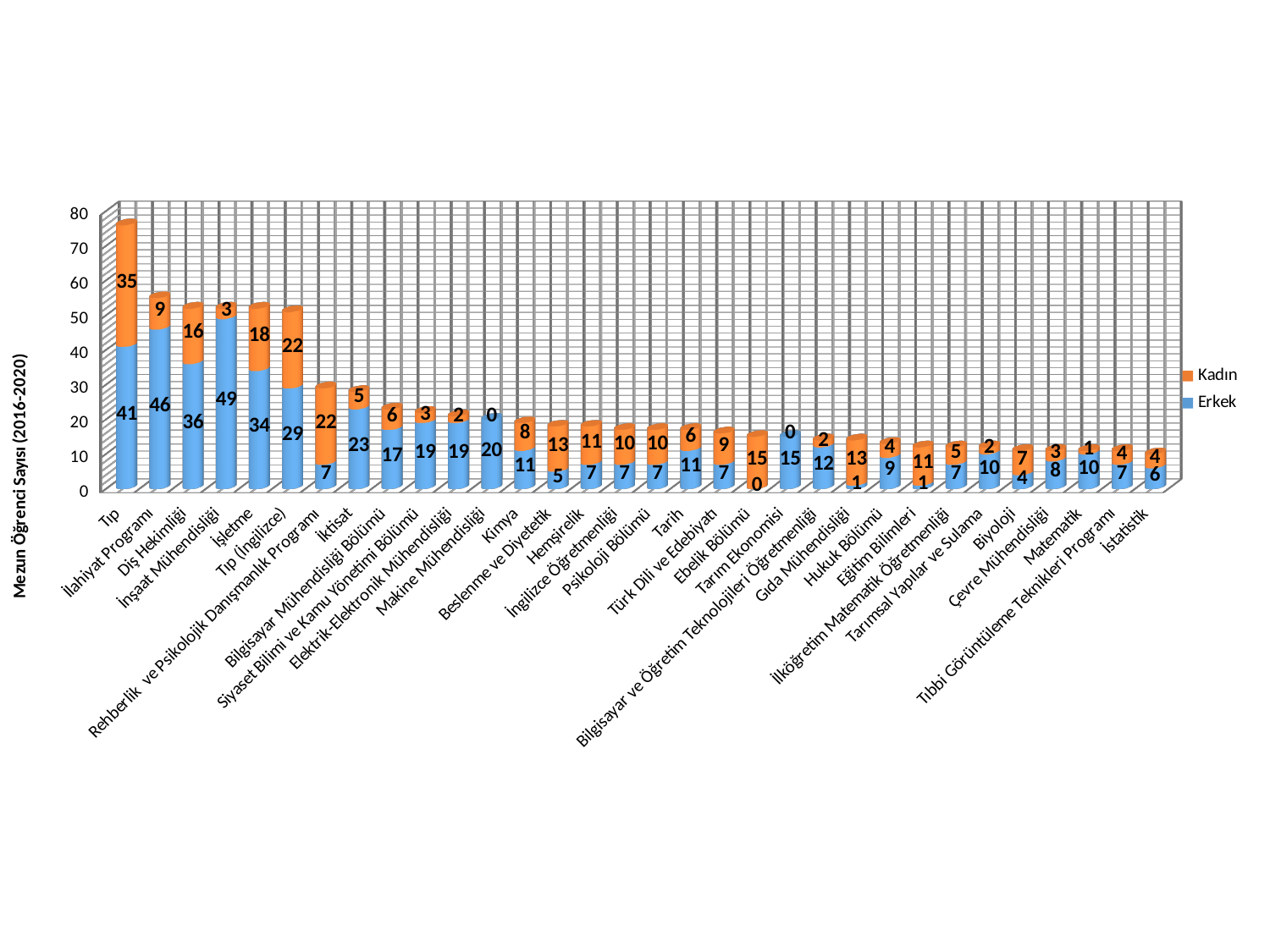
What is the y-axis title of the chart? Mezun Öğrenci Sayısı (2016-2020) What type of chart is shown on the slide? Stacked bar chart What is the Kadın value for Ebelik Bölümü? 15 What is the Kadın value for Rehberlik ve Psikolojik Danışmanlık Programı? 22 Which category has the highest Kadın value? Tıp Is the total of the stacked bar for İlahiyat Programı greater or less than 50? greater What is the Erkek value for Tıp? 41 How many series does the legend list? 2 What is the difference between the Erkek and Kadın values for Diş Hekimliği? 20 What is the total of the stacked bar for Tıp? 76 Which is larger for Beslenme ve Diyetetik, the Erkek value or the Kadın value? Kadın Which category has the highest Erkek value? İnşaat Mühendisliği